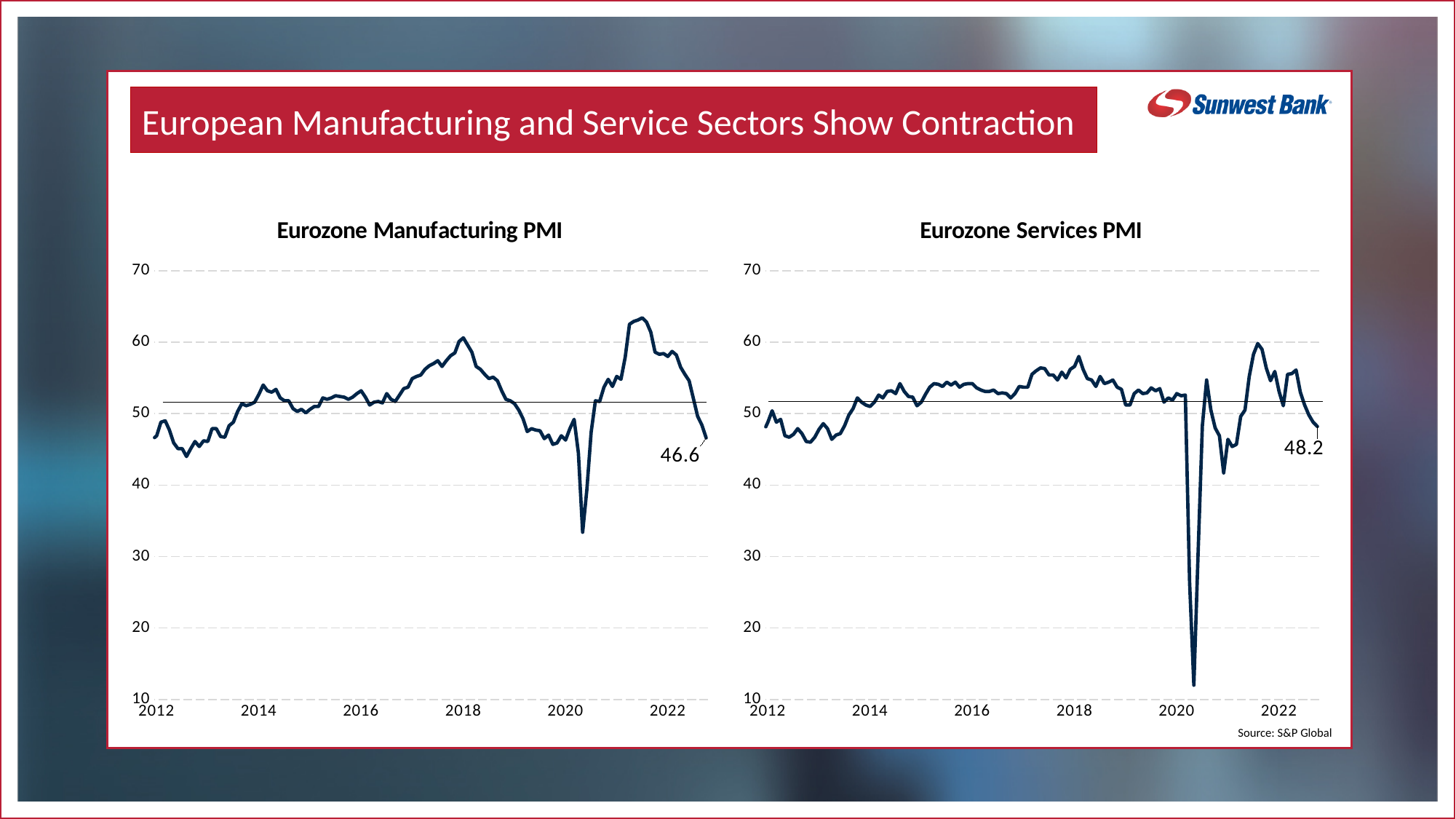
In the Eurozone Services PMI chart, what is the latest value labelled at the end of the line? 48.2 In the Eurozone Manufacturing PMI chart, does the line rise or fall from its 2021 peak to the end of the series? fall In the Eurozone Services PMI chart, is the lowest point of the line (around 2020) greater or less than 20? less Which chart shows the higher labelled latest value, Eurozone Manufacturing PMI or Eurozone Services PMI? Eurozone Services PMI What source is cited for the charts on the slide? S&P Global What kind of chart is the Eurozone Manufacturing PMI chart? Line chart In the Eurozone Manufacturing PMI chart, is the labelled latest value greater or less than 50? less What is the title of the chart on the right side of the slide? Eurozone Services PMI In the Eurozone Manufacturing PMI chart, is the peak of the line in 2021 greater or less than 60? greater What is the difference between the labelled latest Services PMI value and the labelled latest Manufacturing PMI value? 1.6 In the Eurozone Manufacturing PMI chart, what is the latest value labelled at the end of the line? 46.6